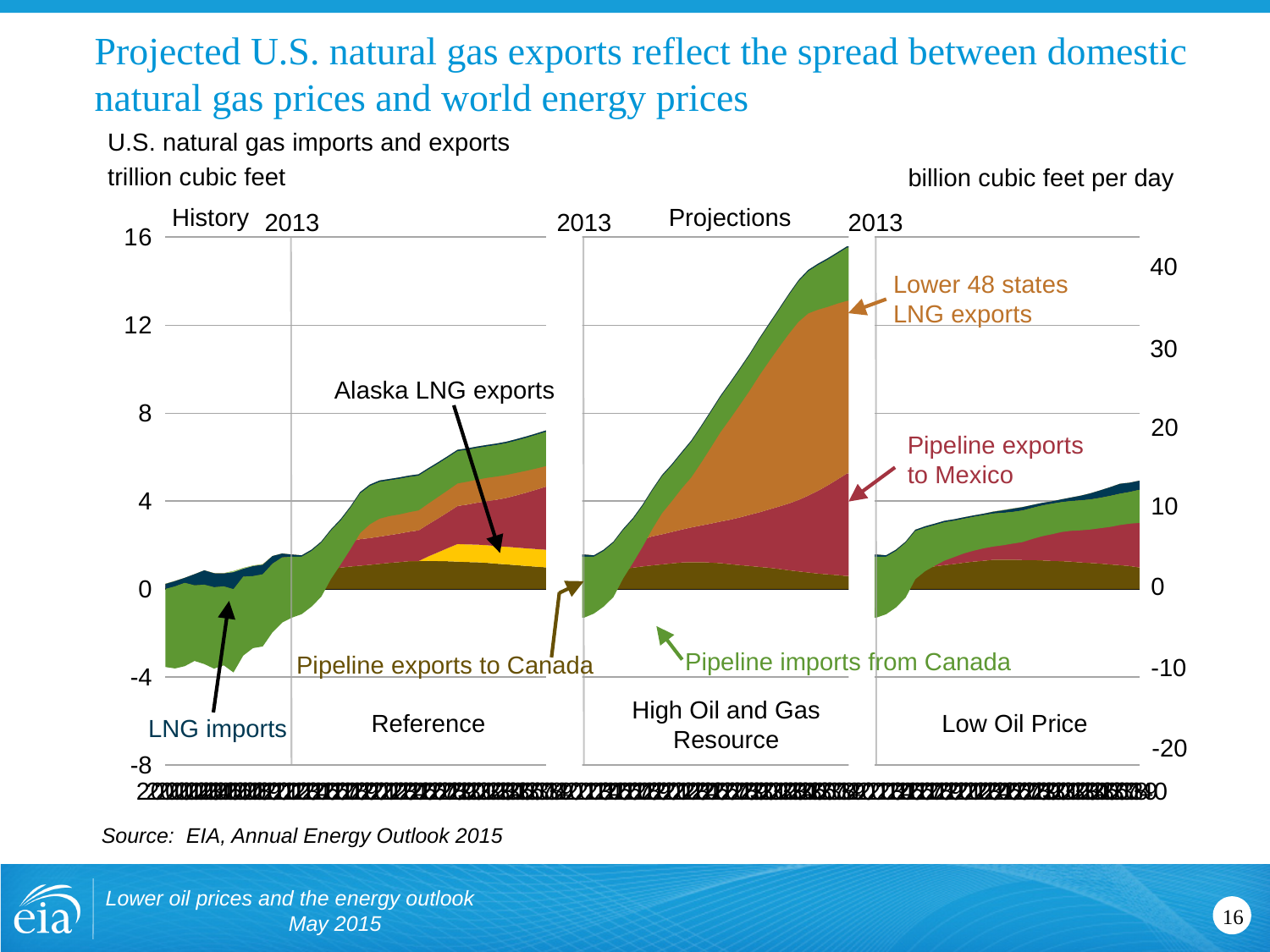
Which series is shown in yellow in the Reference panel? Alaska LNG exports What kind of chart is shown on the slide? area chart In the Low Oil Price panel, is the total of exports at the end of the projection greater or less than 8 trillion cubic feet? less How many scenario panels does the chart show? 3 In the Low Oil Price panel, is the total of exports at the end of the projection greater or less than 10 billion cubic feet per day? greater What is the title of the chart? U.S. natural gas imports and exports Which scenario has the lowest peak total natural gas exports? Low Oil Price In the High Oil and Gas Resource panel, is the peak total of exports greater or less than 12 trillion cubic feet? greater Which scenario reaches the highest total natural gas exports? High Oil and Gas Resource In the Reference panel, do total net exports rise or fall over the projection period after 2013? rise Which three scenarios are shown in the chart panels? Reference, High Oil and Gas Resource, Low Oil Price